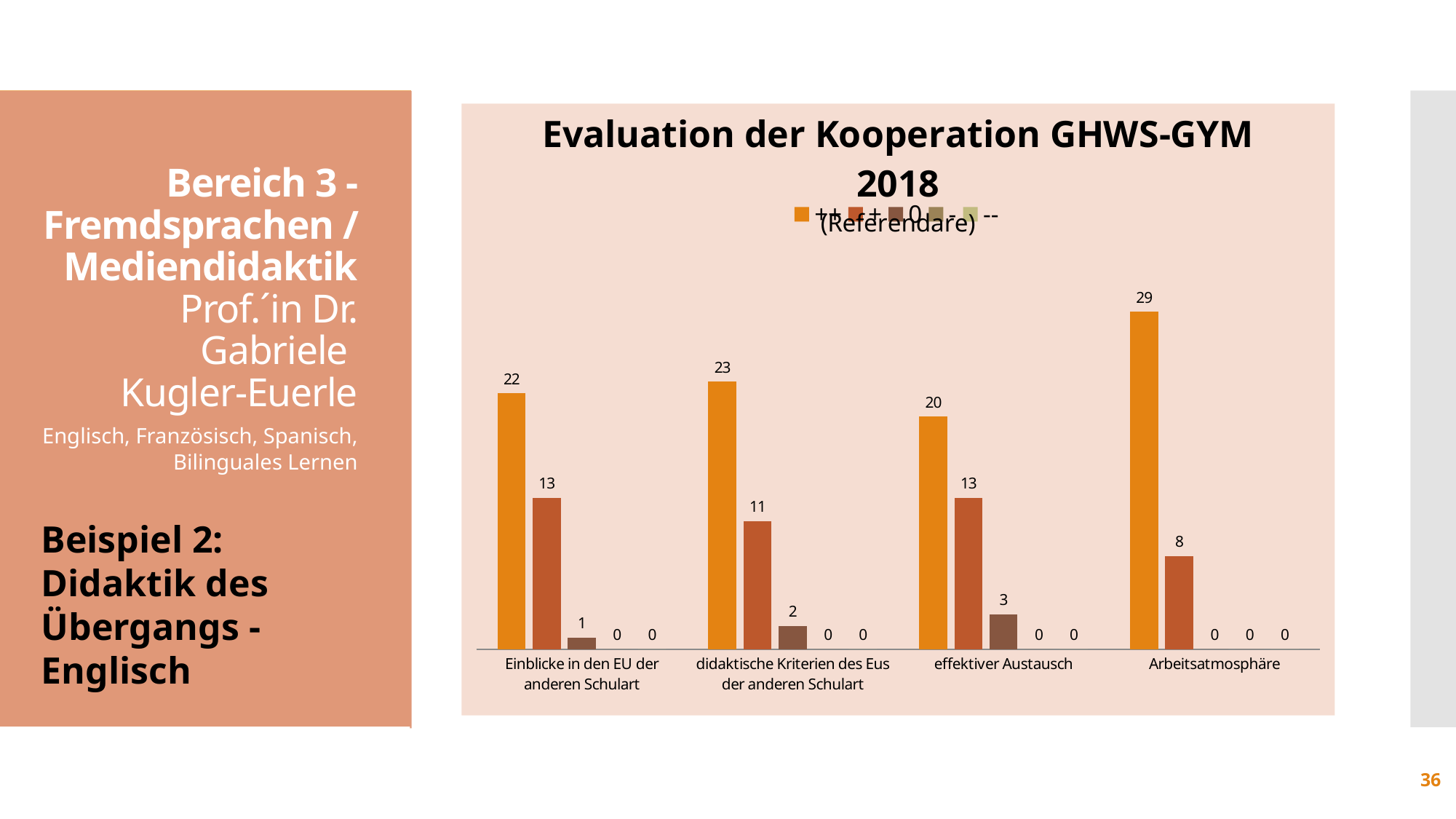
How many categories are shown along the x axis of the chart? 4 What is the title of the chart? Evaluation der Kooperation GHWS-GYM 2018 (Referendare) What kind of chart is shown on the slide? bar chart What is the value of the orange (++) bar for effektiver Austausch? 20 What is the value of the second (+) bar for didaktische Kriterien des Eus der anderen Schulart? 11 What is the value of the orange (++) bar for Arbeitsatmosphäre? 29 Which category has the lowest second (+) bar? Arbeitsatmosphäre What is the value of the third (0) bar for effektiver Austausch? 3 What is the difference between the orange (++) bar and the second (+) bar for Einblicke in den EU der anderen Schulart? 9 How many series does the chart's legend list? 5 Which is larger: the orange (++) bar for Einblicke in den EU der anderen Schulart or the orange (++) bar for didaktische Kriterien des Eus der anderen Schulart? didaktische Kriterien des Eus der anderen Schulart Which category has the highest orange (++) bar? Arbeitsatmosphäre